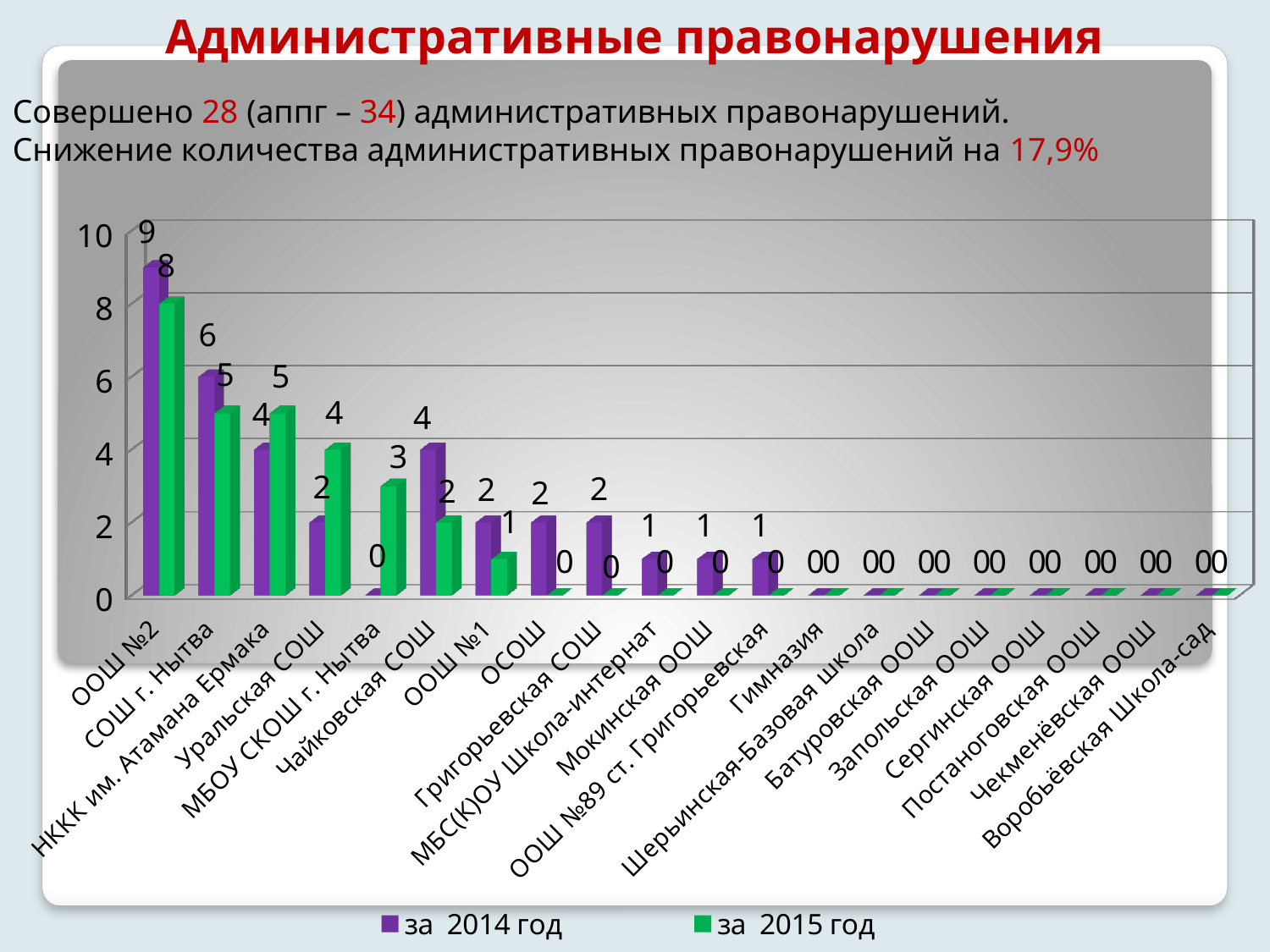
What type of chart is shown on the slide? bar chart What is the difference between the 2015 and 2014 values for Уральская СОШ? 2 What is the value for Чайковская СОШ in the series 'за 2014 год'? 4 How many schools (categories) are shown on the x axis? 20 What is the value for МБОУ СКОШ г. Нытва in the series 'за 2015 год'? 3 For Уральская СОШ, which is larger: the value for 2014 or the value for 2015? 2015 Which colour represents the series 'за 2015 год'? green How many series does the legend list? 2 What is the value for ООШ №2 in the series 'за 2014 год'? 9 What is the value for ООШ №2 in the series 'за 2015 год'? 8 What is the difference between the 2014 and 2015 values for СОШ г. Нытва? 1 Which school has the highest value in the series 'за 2014 год'? ООШ №2